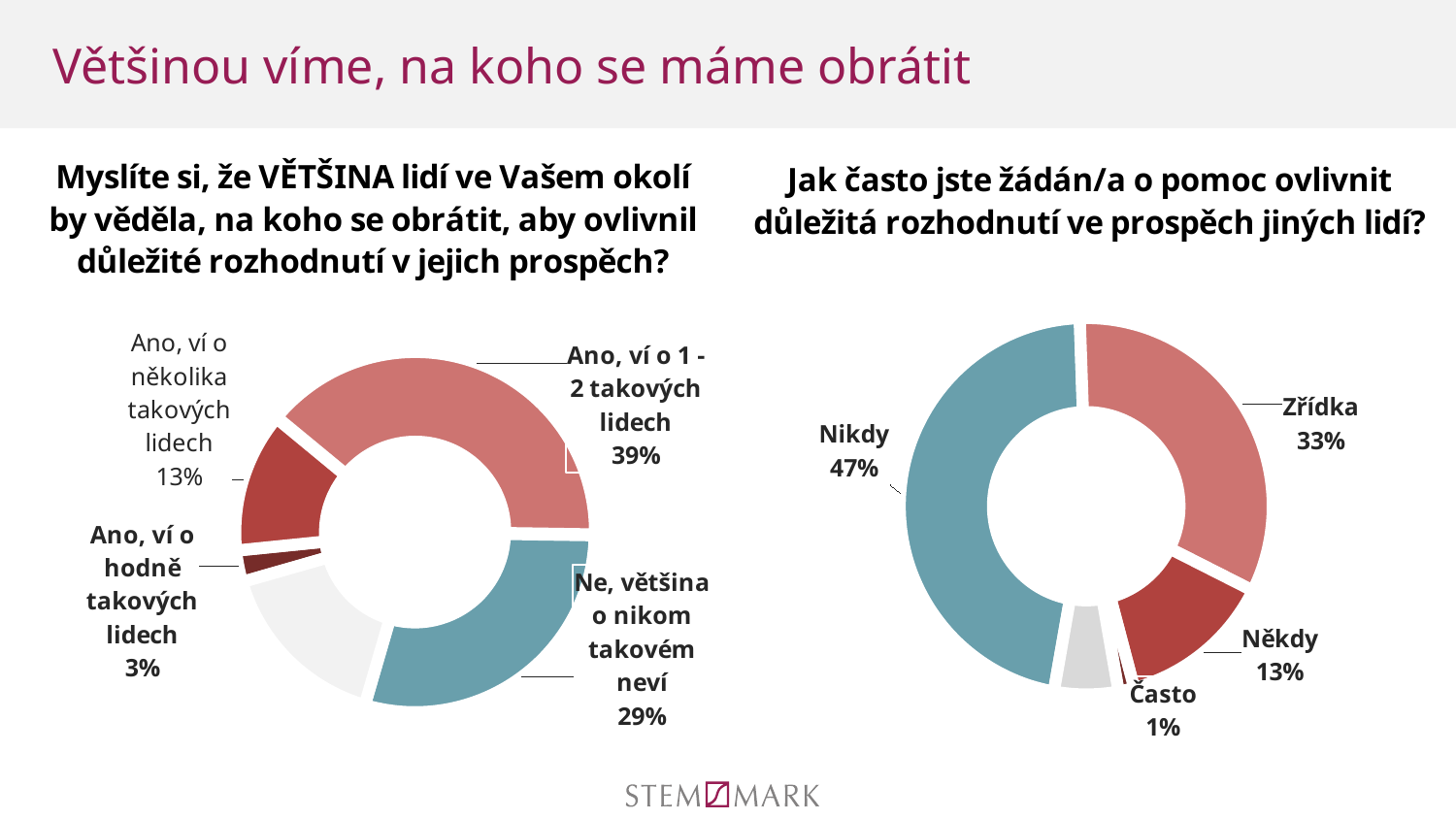
In the left chart, what percentage is shown for "Ne, většina o nikom takovém neví"? 29% What type of chart is used on the right side of the slide? Doughnut (pie) chart In the left chart, what percentage is shown for "Ano, ví o hodně takových lidech"? 3% In the left chart, what is the difference in percentage points between "Ano, ví o 1 - 2 takových lidech" and "Ne, většina o nikom takovém neví"? 10 percentage points In the right chart, what percentage is shown for "Zřídka"? 33% In the right chart (Jak často jste žádán/a o pomoc...), what share of respondents answered "Nikdy"? 47% In the right chart, which answer has the smallest share? Často In the right chart, which is larger: "Někdy" or "Zřídka"? Zřídka In the left chart, which labelled answer has the smallest share? Ano, ví o hodně takových lidech In the left chart, which labelled answer has the largest share? Ano, ví o 1 - 2 takových lidech In the right chart, what is the difference in percentage points between "Nikdy" and "Zřídka"? 14 percentage points In the left chart (Myslíte si, že VĚTŠINA lidí ve Vašem okolí...), what share of respondents answered "Ano, ví o 1 - 2 takových lidech"? 39%